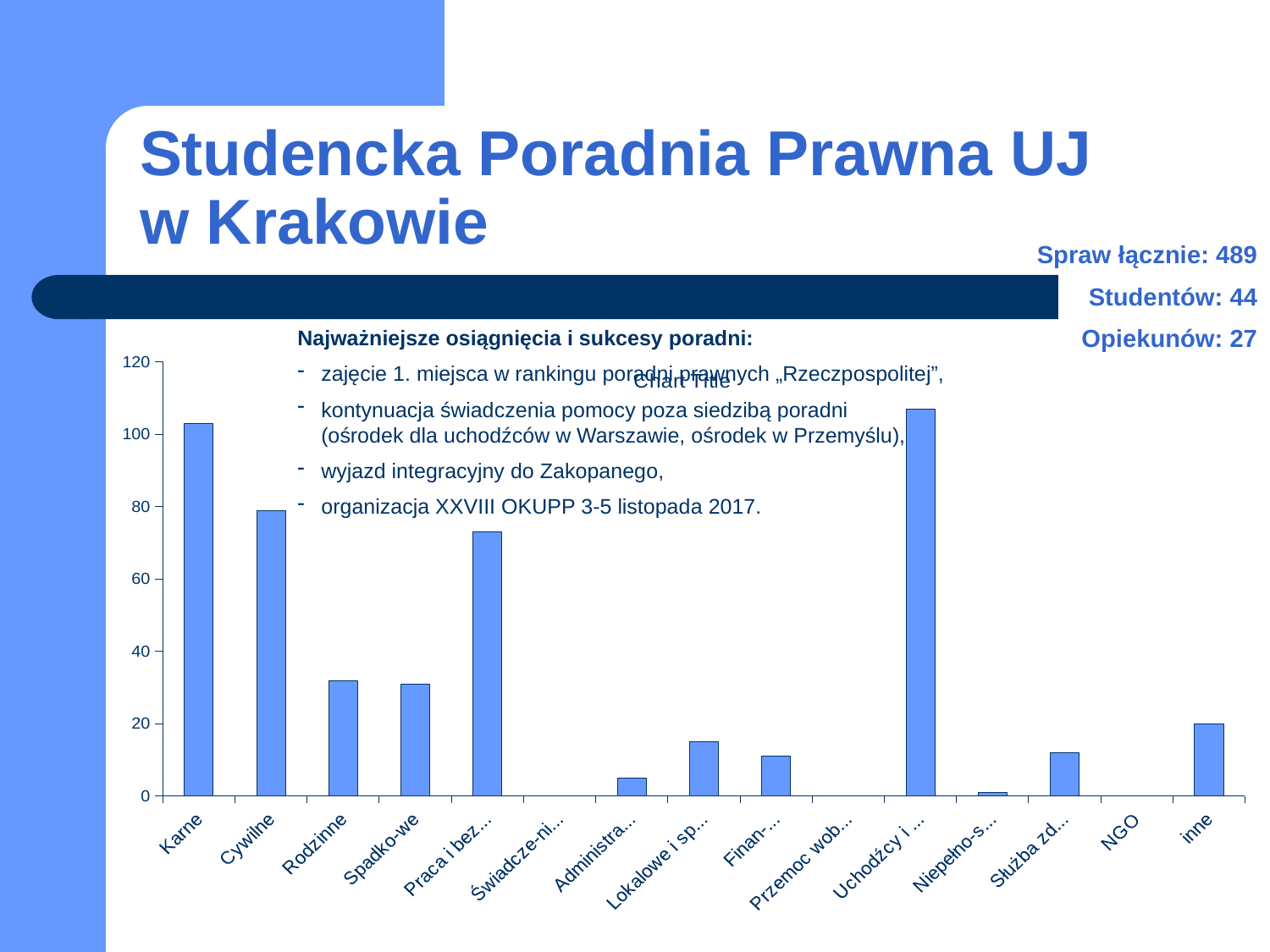
Is the value for Uchodźcy i ... greater or less than 100? greater Is the value for Karne greater or less than 100? greater How many categories are shown on the x axis of the chart? 15 Is the value for Rodzinne greater or less than 40? less What is the title shown above the chart? Chart Title Which is larger, the value for Praca i bez... or the value for Rodzinne? Praca i bez... Which is larger, the value for Karne or the value for Cywilne? Karne What kind of chart is shown on the slide? bar chart Which is larger, the value for Służba zd... or the value for Niepełno-s...? Służba zd...